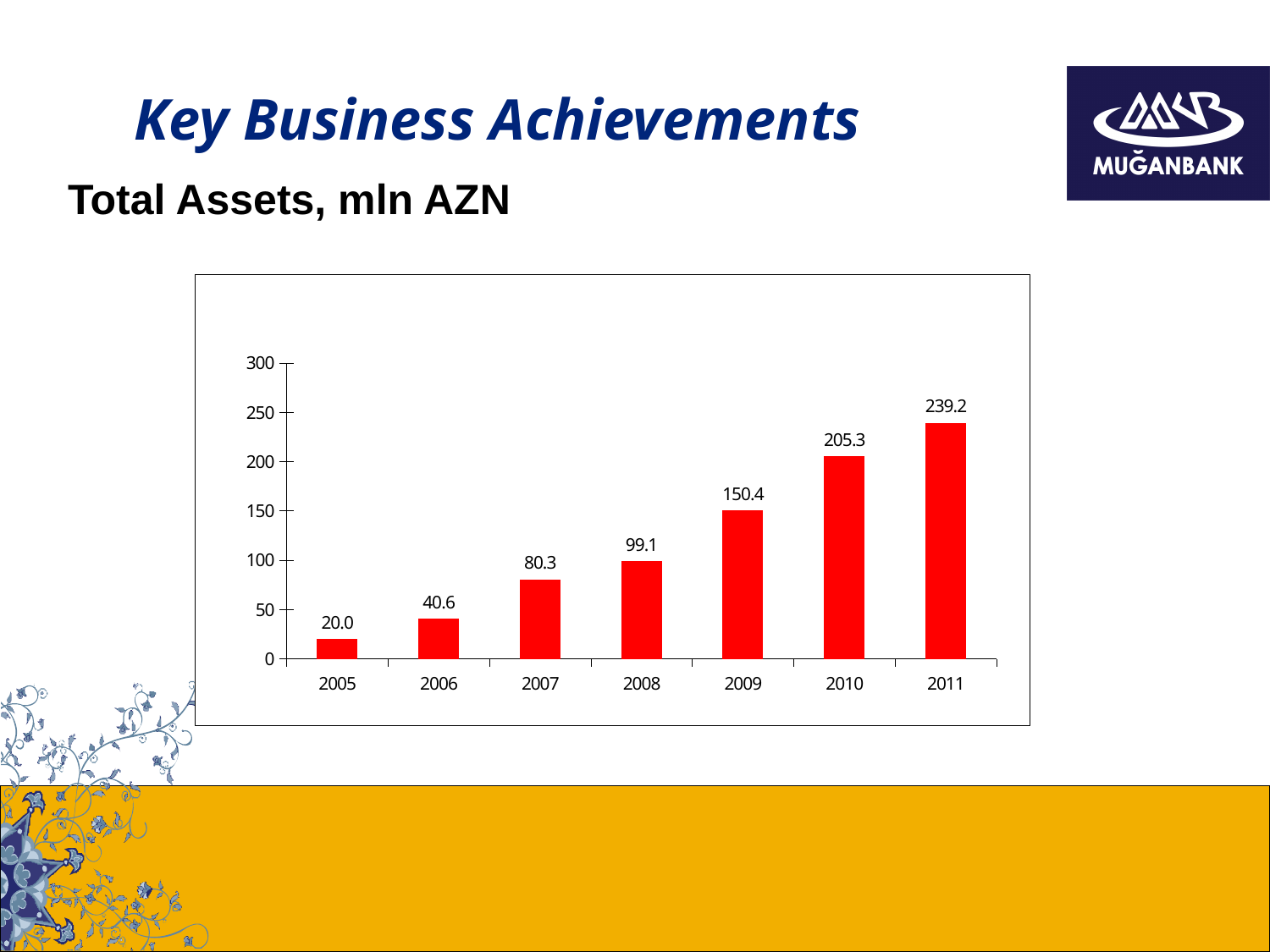
What kind of chart is shown on the slide? Bar chart How many years are shown on the x axis of the chart? 7 What is the difference in Total Assets between 2009 and 2007? 70.1 What is the difference in Total Assets between 2011 and 2010? 33.9 What is the value of Total Assets for 2008? 99.1 What is the value of Total Assets for 2010? 205.3 Which year has the highest Total Assets? 2011 Do Total Assets rise or fall from 2005 to 2011? Rise Which year has the lowest Total Assets? 2005 Is the value for 2009 greater or less than 100? greater Which year has larger Total Assets, 2006 or 2007? 2007 What is the value of Total Assets for 2005? 20.0